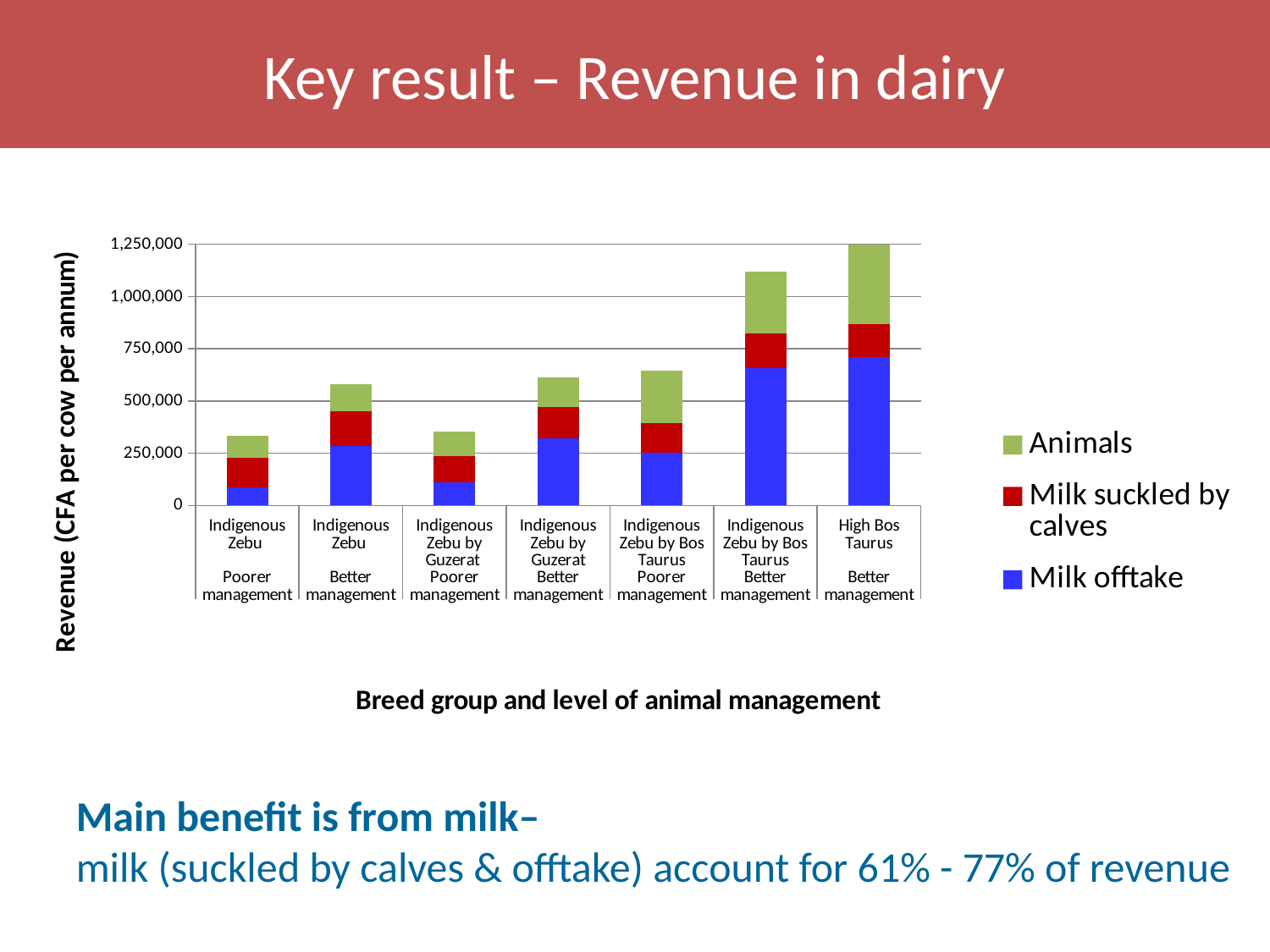
Which has the larger total revenue: Indigenous Zebu (Better management) or Indigenous Zebu by Guzerat (Poorer management)? Indigenous Zebu (Better management) Is the total revenue for Indigenous Zebu (Poorer management) greater or less than 500,000? less Is the total revenue for Indigenous Zebu by Bos Taurus (Better management) greater or less than 1,000,000? greater Is the Milk offtake value for High Bos Taurus (Better management) greater or less than 500,000? greater Which series is shown in green in the legend? Animals Which category has the highest total revenue? High Bos Taurus, Better management How many series does the legend list? 3 What is the title of the vertical axis? Revenue (CFA per cow per annum) What kind of chart is shown on the slide? Stacked bar chart Which has the larger Milk offtake value: Indigenous Zebu by Bos Taurus (Better management) or Indigenous Zebu by Bos Taurus (Poorer management)? Indigenous Zebu by Bos Taurus (Better management) How many breed group / management categories are shown on the x axis? 7